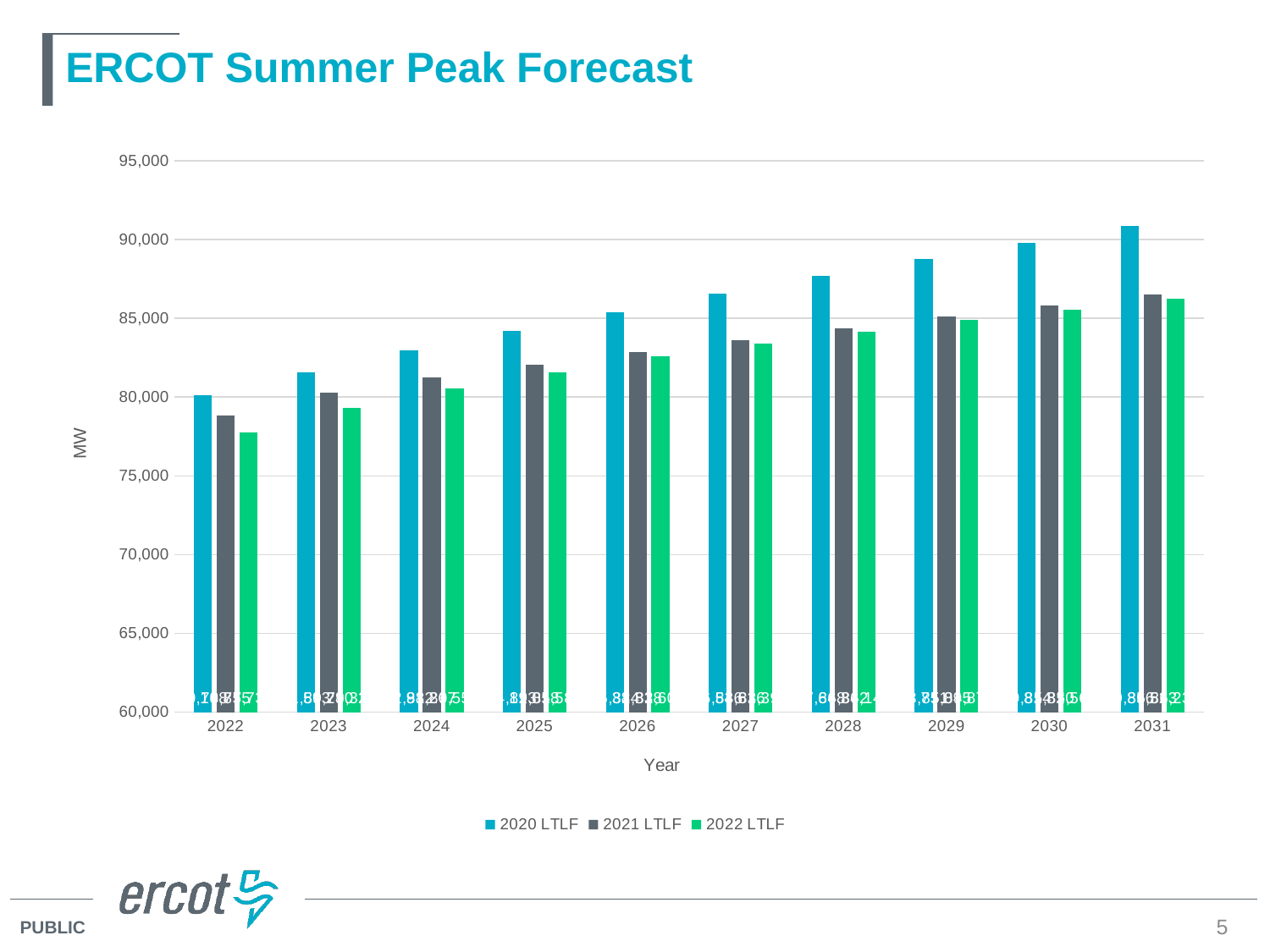
In which year is the 2022 LTLF value lowest? 2022 How many series does the legend list? 3 Do the 2022 LTLF values rise or fall from 2022 to 2031? rise Is the 2021 LTLF value for 2026 greater or less than 85,000? less Is the 2020 LTLF value for 2031 greater or less than 90,000? greater Is the 2020 LTLF value for 2028 greater or less than 85,000? greater For 2025, which series has the larger value, 2020 LTLF or 2022 LTLF? 2020 LTLF In which year is the 2020 LTLF value highest? 2031 What kind of chart is shown on the slide? bar chart What is the label on the vertical axis? MW How many years are shown on the x axis? 10